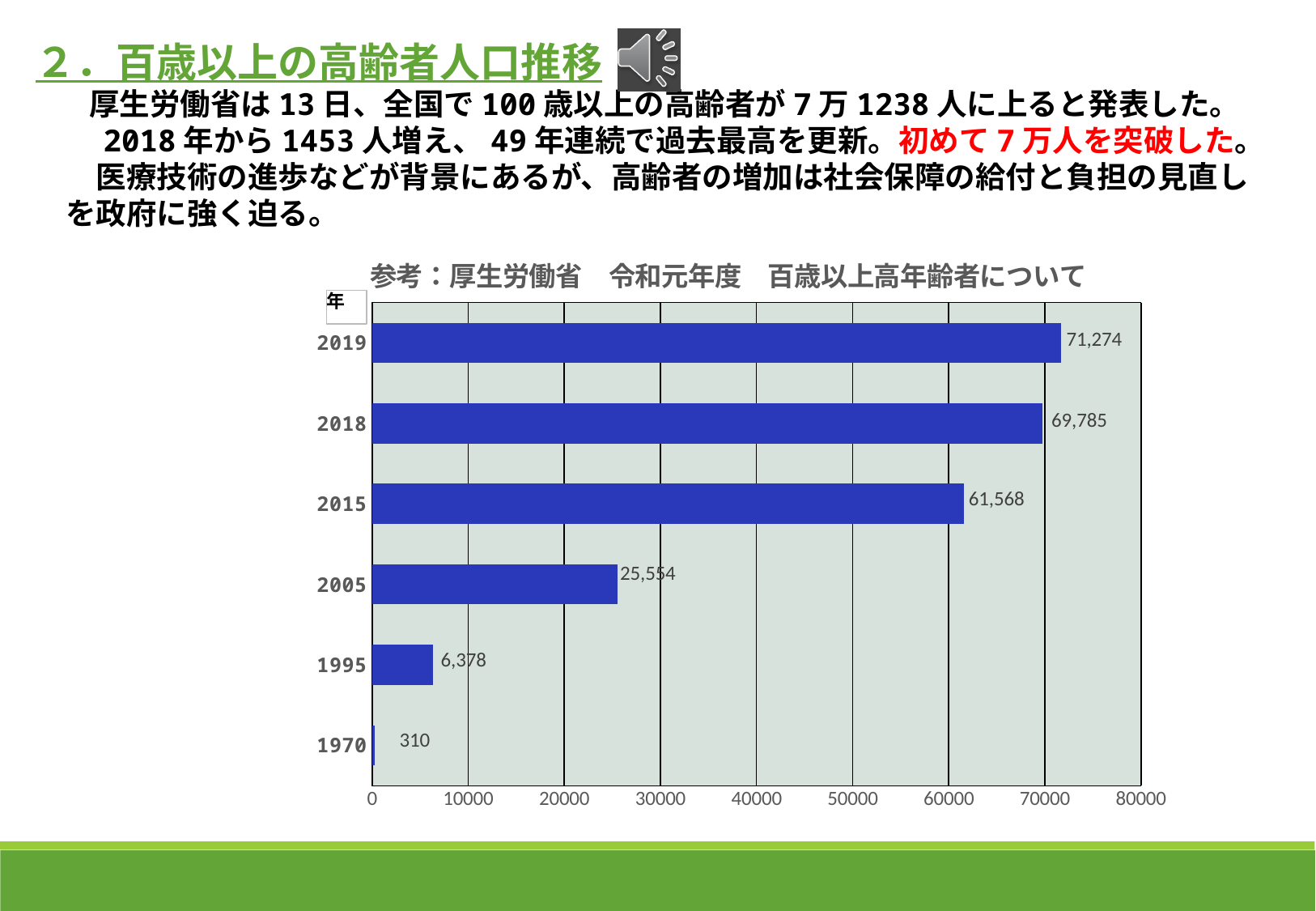
What is the title of the chart? 参考：厚生労働省 令和元年度 百歳以上高年齢者について What is the difference between the values for 2015 and 2005? 36,014 What kind of chart is shown on the slide? bar chart Which year has the lowest value? 1970 Which year has the highest value? 2019 Which is larger, the value for 1995 or the value for 2005? 2005 What is the difference between the values for 2019 and 2018? 1,489 How many years are shown in the chart? 6 What is the value for 1970? 310 Is the value for 2015 greater or less than 60000? greater What is the value for 2005? 25,554 What is the value for 2019? 71,274